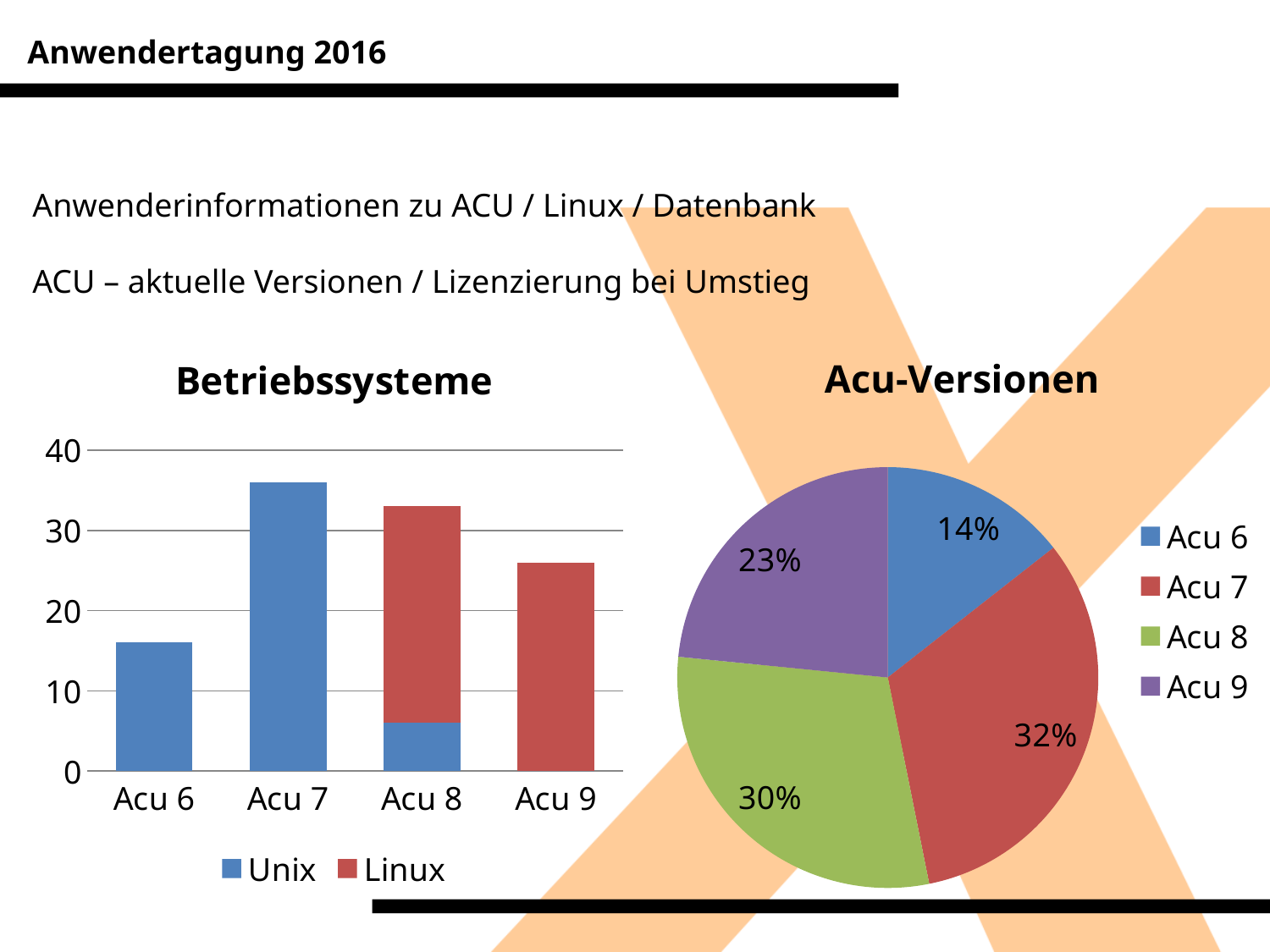
In the Acu-Versionen pie chart, which version has the smallest slice? Acu 6 What kind of chart is the Acu-Versionen chart? Pie chart In the Betriebssysteme chart, is the value for Acu 6 greater or less than 20? less What kind of chart is the Betriebssysteme chart? Bar chart How many series does the legend of the Betriebssysteme chart list? 2 How many slices does the Acu-Versionen pie chart have? 4 In the Betriebssysteme chart, which category has both a Unix and a Linux segment? Acu 8 In the Acu-Versionen pie chart, what is the difference in percentage points between Acu 9 and Acu 6? 9 percentage points In the Acu-Versionen pie chart, what share does Acu 7 have? 32% In the Betriebssysteme chart, which bar is taller, Acu 7 or Acu 6? Acu 7 In the Acu-Versionen pie chart, which version has the largest slice? Acu 7 In the Betriebssysteme chart, is the value for Acu 7 greater or less than 30? greater